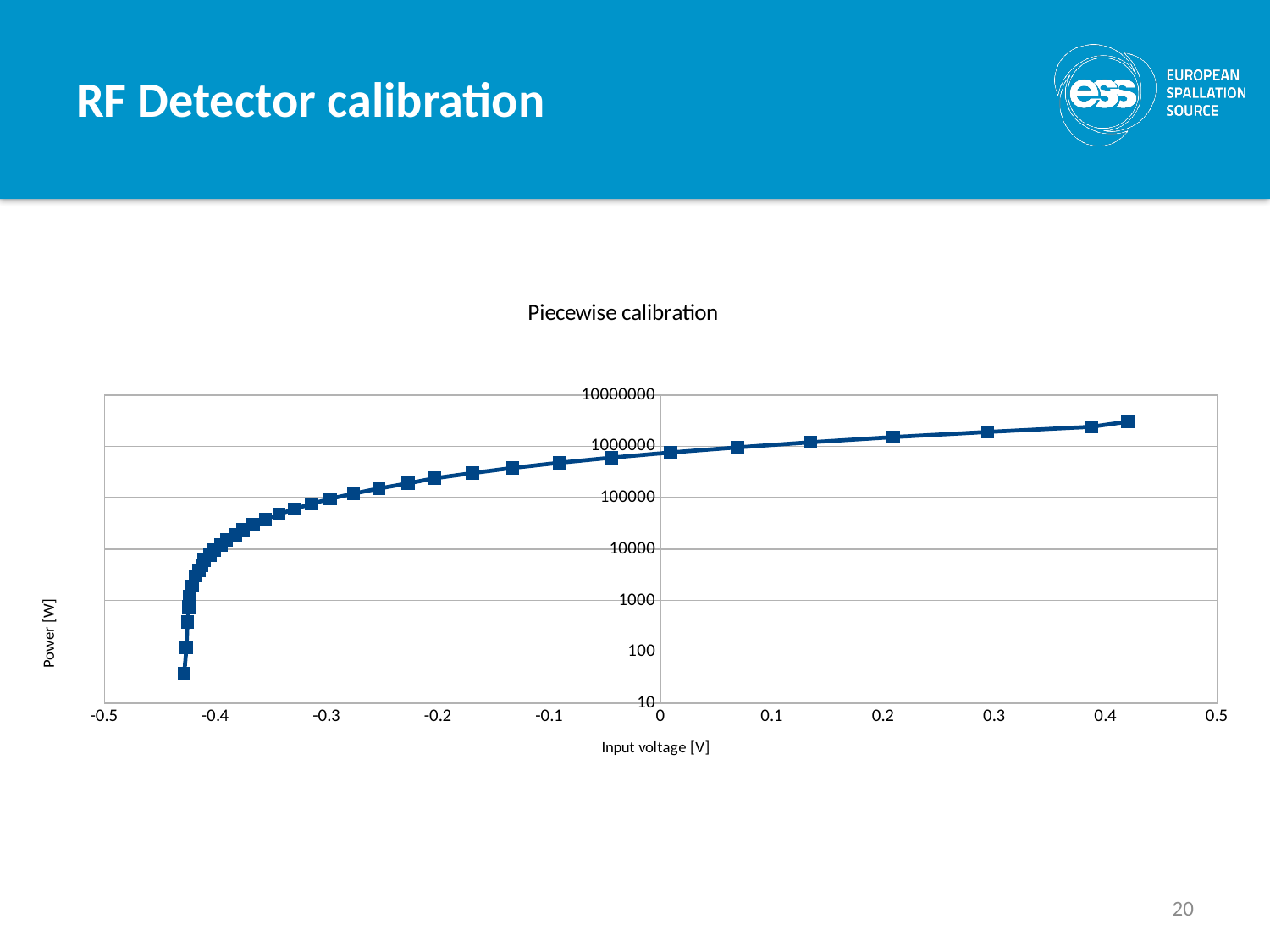
What is the highest tick value shown on the y axis of the chart? 10000000 Is the power at an input voltage of 0.2 V greater or less than 1000000? greater Is the power at an input voltage of -0.2 V greater or less than 1000000? less Is the power at an input voltage of -0.1 V greater or less than 1000000? less Does the power rise or fall as the input voltage increases along the x axis? rise What kind of chart is shown on the slide? line chart What is the label of the x axis of the chart? Input voltage [V] What is the title of the chart? Piecewise calibration Which is larger, the power at an input voltage of 0.3 V or the power at an input voltage of -0.3 V? 0.3 V